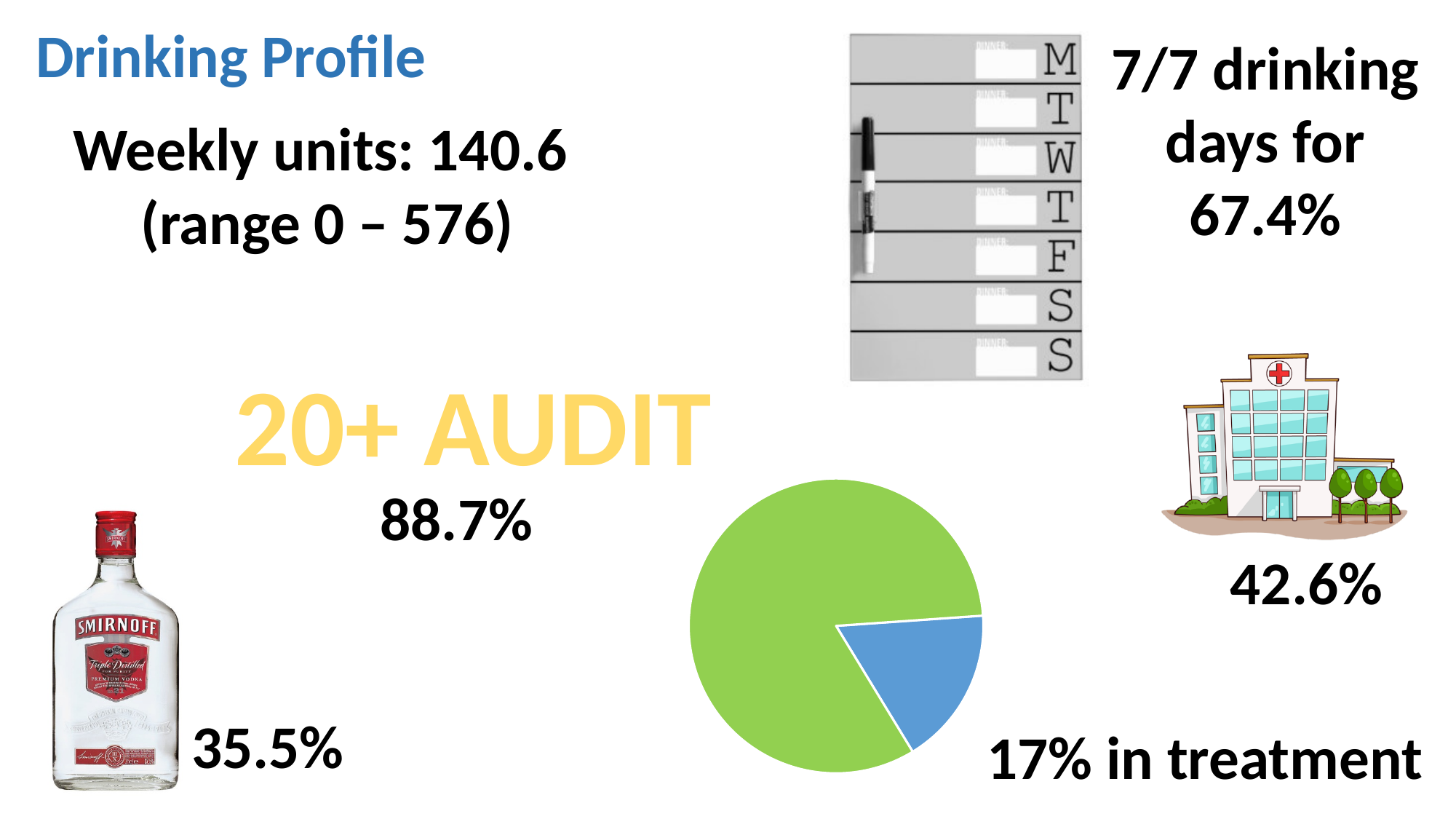
How many slices does the pie chart have? 2 Which colour is the smallest slice of the pie chart? blue Which colour is the largest slice of the pie chart? green Is the blue slice of the pie chart greater or less than half of the pie? less What kind of chart is shown on the slide? pie chart Which slice of the pie chart is larger, the green one or the blue one? green Does the pie chart have a legend? No Is the green slice of the pie chart greater or less than half of the pie? greater What two colours are used for the slices of the pie chart? green and blue What percentage is labelled as 'in treatment' next to the pie chart? 17%